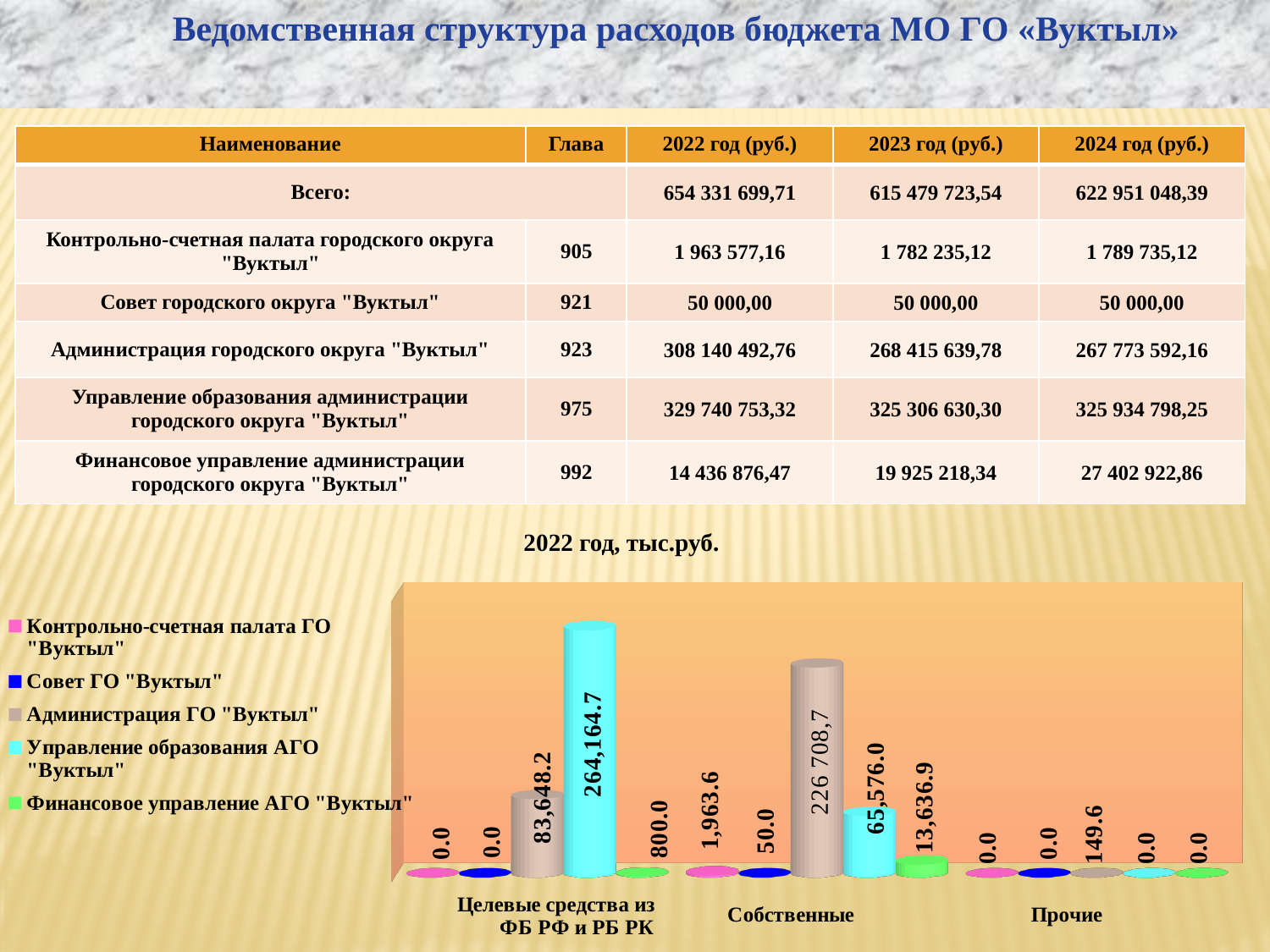
Which is larger: the value for Администрация ГО "Вуктыл" in Целевые средства из ФБ РФ и РБ РК or in Собственные? Собственные Which series has the highest value in the category Собственные? Администрация ГО "Вуктыл" Which series has the highest value in the category Целевые средства из ФБ РФ и РБ РК? Управление образования АГО "Вуктыл" What is the value for Управление образования АГО "Вуктыл" in the category Целевые средства из ФБ РФ и РБ РК? 264,164.7 What is the title of the chart? 2022 год, тыс.руб. What is the value for Администрация ГО "Вуктыл" in the category Прочие? 149.6 What is the value for Администрация ГО "Вуктыл" in the category Собственные? 226 708,7 What is the value for Финансовое управление АГО "Вуктыл" in the category Собственные? 13,636.9 What kind of chart is shown on the slide? bar chart What is the value for Совет ГО "Вуктыл" in the category Собственные? 50.0 How many categories are shown along the x axis of the chart? 3 How many series does the chart legend list? 5